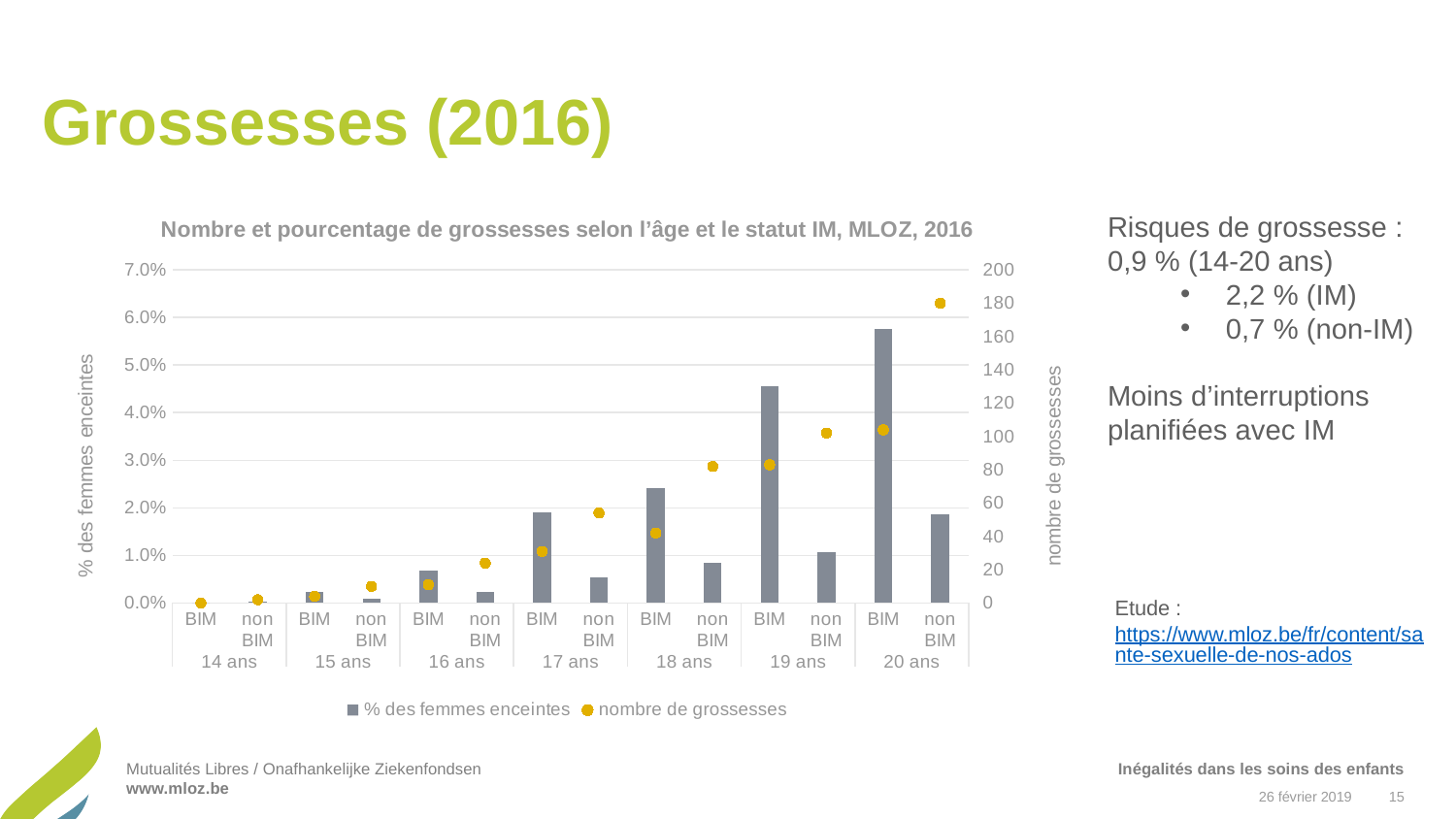
Is the 'nombre de grossesses' value for 20 ans non BIM greater or less than 160? greater How many age groups are shown along the x axis? 7 What kind of chart is shown on the slide? A combined bar and dot (line marker) chart Which is larger, the 'nombre de grossesses' value for 18 ans BIM or for 18 ans non BIM? 18 ans non BIM Is the '% des femmes enceintes' value for 20 ans BIM greater or less than 5.0%? greater Which category has the highest value for 'nombre de grossesses'? 20 ans non BIM What is the title of the chart? Nombre et pourcentage de grossesses selon l'âge et le statut IM, MLOZ, 2016 Which is larger, the '% des femmes enceintes' value for 19 ans BIM or for 19 ans non BIM? 19 ans BIM Is the '% des femmes enceintes' value for 19 ans non BIM greater or less than 2.0%? less How many series does the legend list? 2 Which category has the highest value for '% des femmes enceintes'? 20 ans BIM Do the 'nombre de grossesses' values for non BIM generally rise or fall as age increases from 14 ans to 20 ans? rise